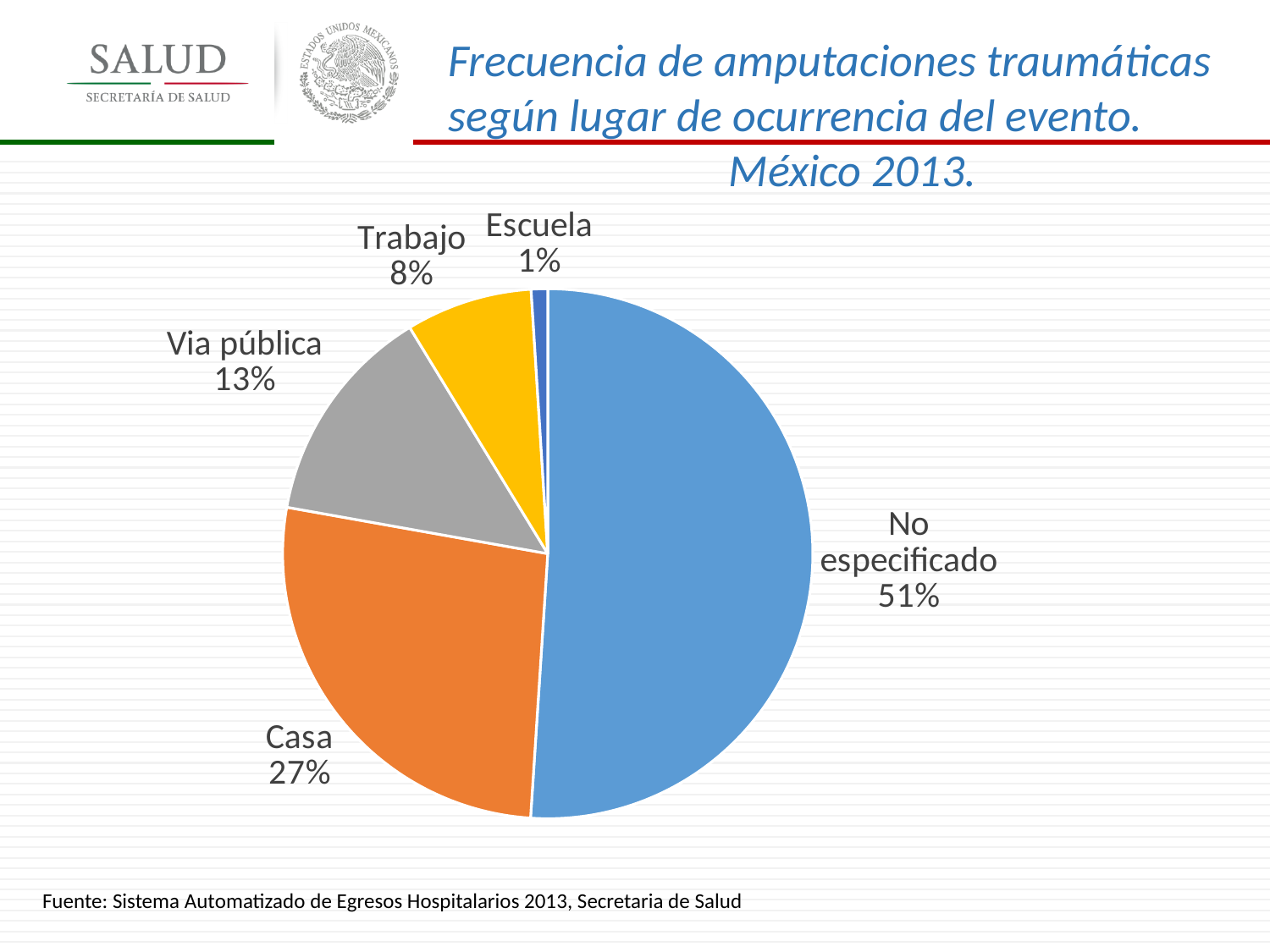
What share of the pie does "Casa" represent? 27% Which category has the largest slice of the pie? No especificado Which is larger, the share for "Trabajo" or the share for "Via pública"? Via pública What kind of chart is shown on the slide? pie chart What colour is the slice for "Casa"? orange What is the difference between the shares for "Casa" and "Via pública"? 14% What is the value shown for "Trabajo"? 8% How many categories (slices) are shown in the pie chart? 5 Which category has the smallest slice of the pie? Escuela What is the value shown for "Via pública"? 13% What is the value shown for "Escuela"? 1% What share of the pie does "No especificado" represent? 51%